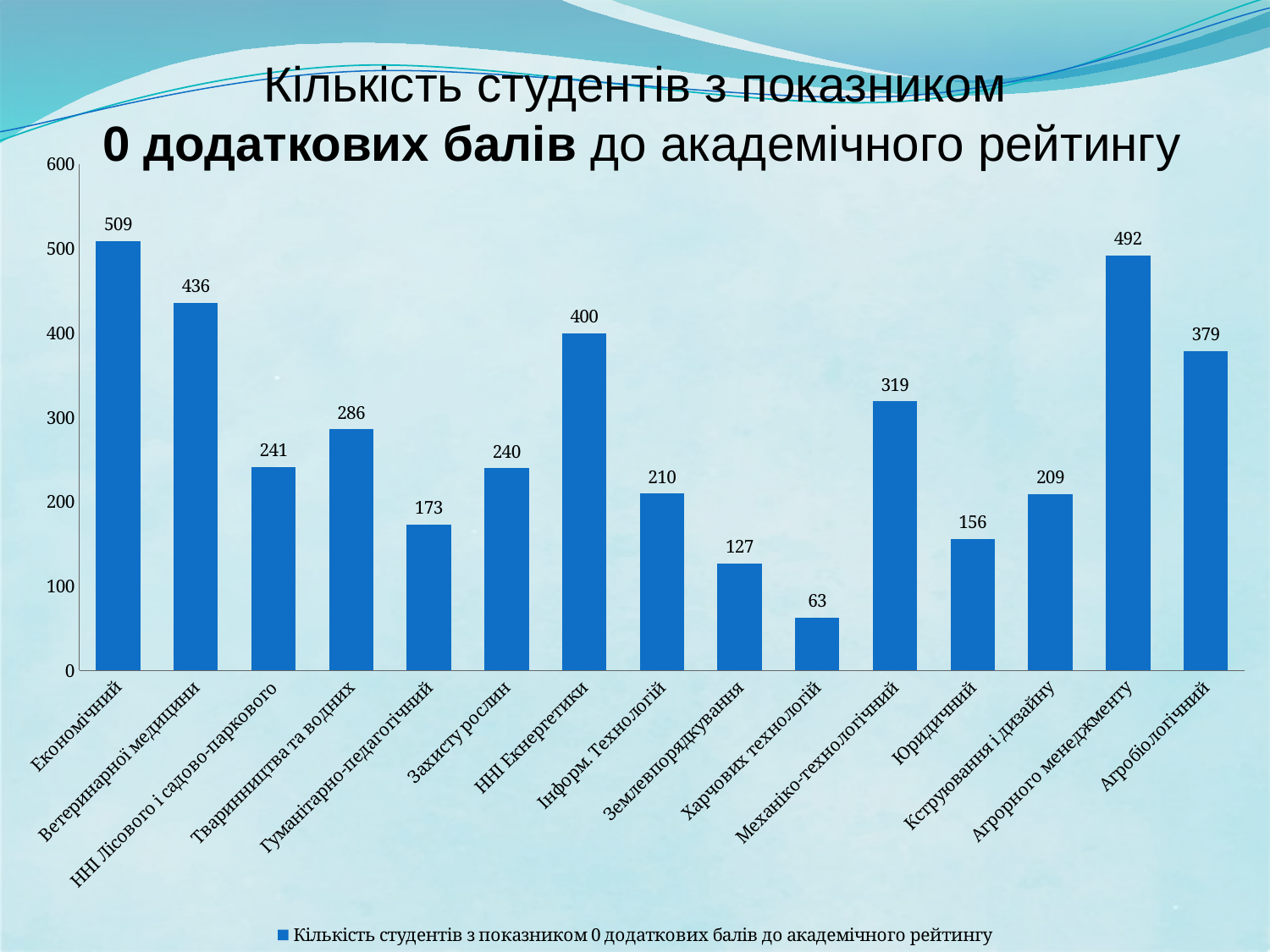
How many categories are shown on the x axis? 15 What is the value for Економічний? 509 What is the difference between the values for Економічний and Ветеринарної медицини? 73 Which category has the highest value? Економічний Which is larger, the value for ННІ Екнергетики or the value for Агробіологічний? ННІ Екнергетики What is the value for Агрорного менеджменту? 492 Which category has the lowest value? Харчових технологій What is the value for Юридичний? 156 What is the value for Харчових технологій? 63 How many series does the legend list? 1 What kind of chart is shown on the slide? bar chart Is the value for Механіко-технологічний greater or less than 300? greater